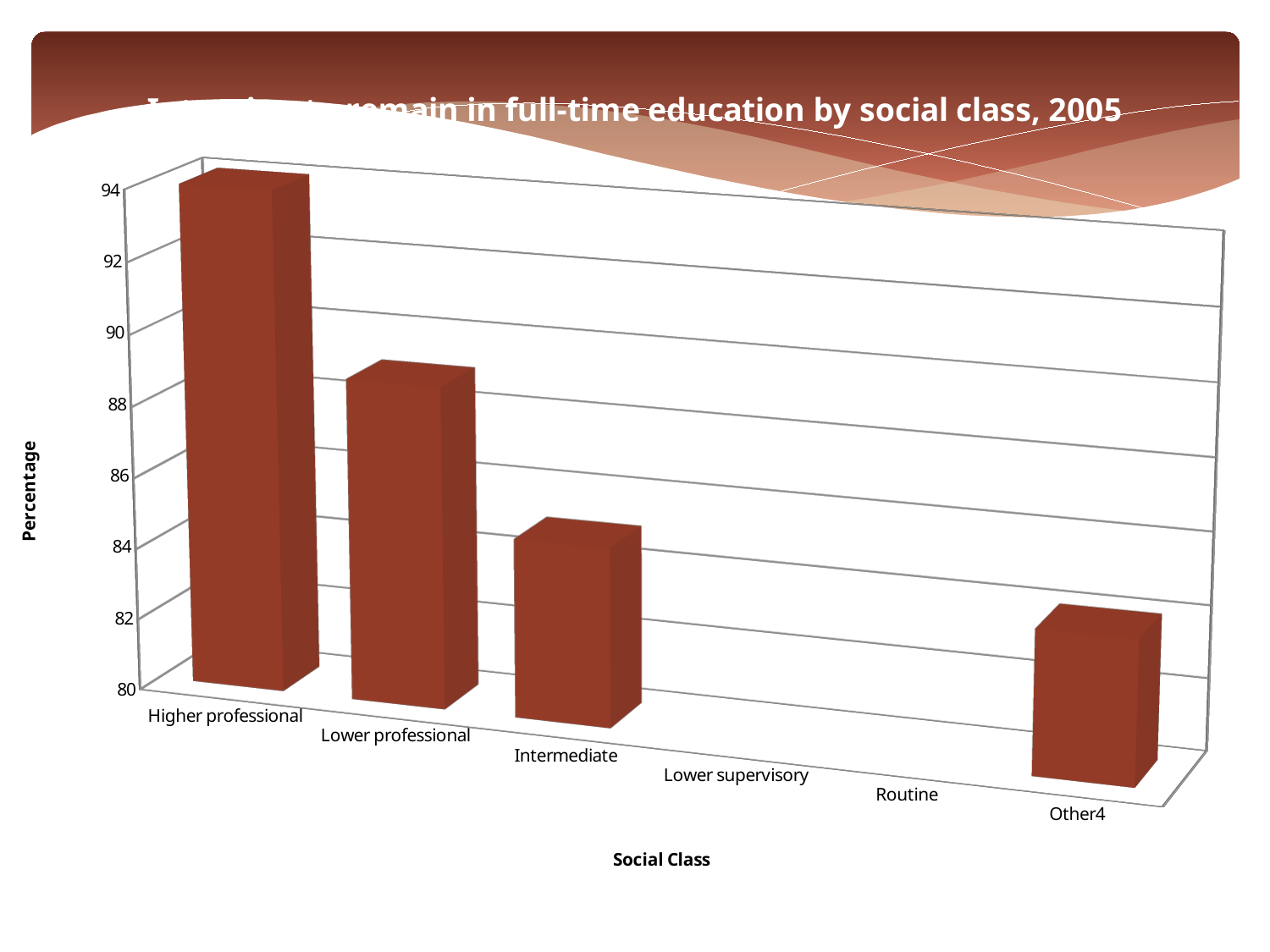
Do the values rise or fall from Higher professional to Intermediate? fall What kind of chart is shown on the slide? bar chart Is the value for Lower professional greater or less than 90? less Is the value for Lower professional greater or less than 86? greater Is the value for Intermediate greater or less than 86? less Which social class has the highest bar? Higher professional Which is larger, the value for Intermediate or the value for Other4? Intermediate Which is larger, the value for Lower professional or the value for Intermediate? Lower professional What is the title of the vertical axis? Percentage How many social class categories are listed on the x axis? 6